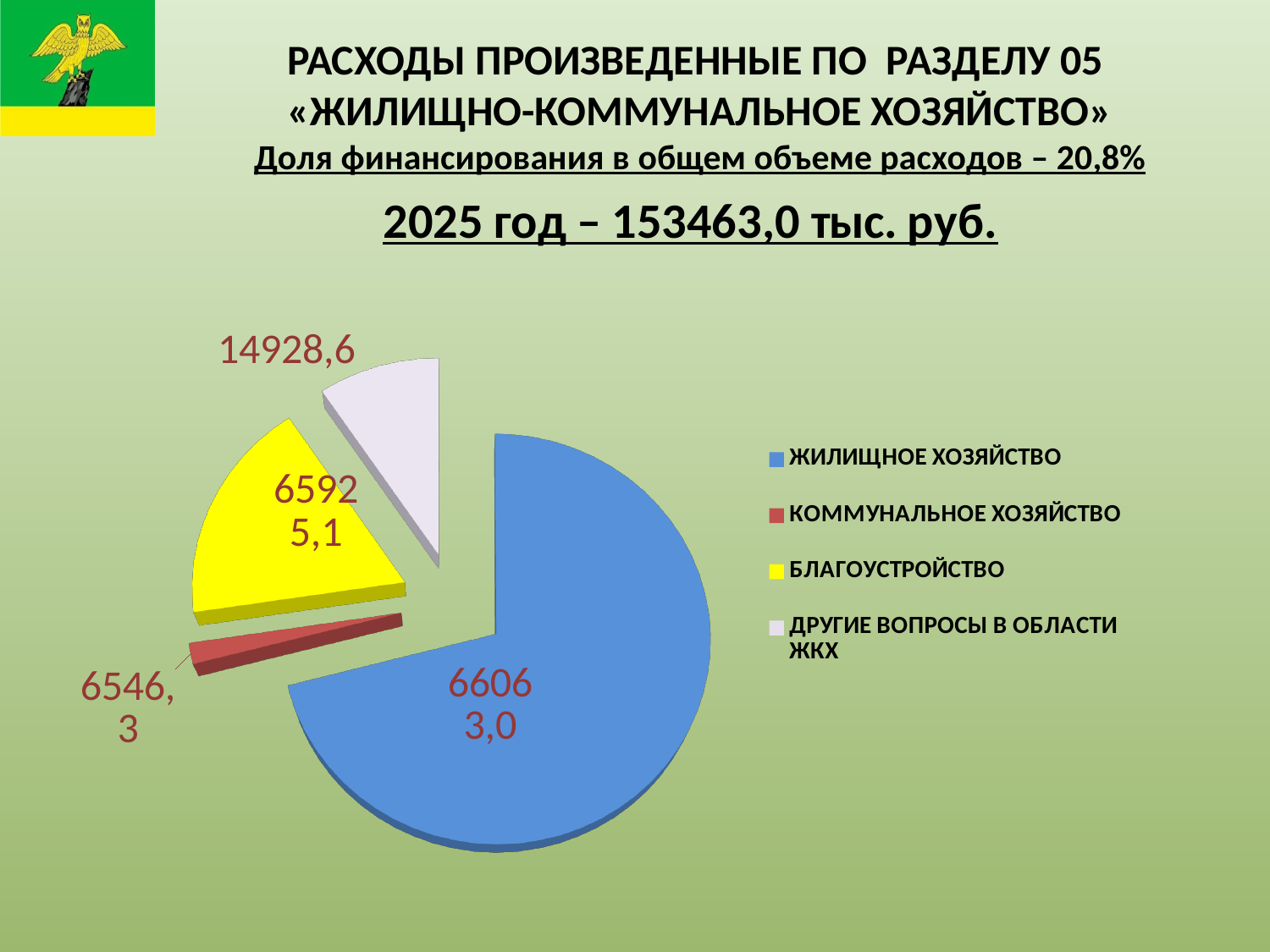
What is the value shown for КОММУНАЛЬНОЕ ХОЗЯЙСТВО? 6546,3 Which category has the smallest slice of the pie? КОММУНАЛЬНОЕ ХОЗЯЙСТВО How many slices does the pie chart have? 4 What total amount for 2025 is stated above the pie chart? 153463,0 тыс. руб. What kind of chart is shown on the slide? pie chart What is the difference between the values for ДРУГИЕ ВОПРОСЫ В ОБЛАСТИ ЖКХ and КОММУНАЛЬНОЕ ХОЗЯЙСТВО? 8382,3 Which is larger, the value for ДРУГИЕ ВОПРОСЫ В ОБЛАСТИ ЖКХ or the value for КОММУНАЛЬНОЕ ХОЗЯЙСТВО? ДРУГИЕ ВОПРОСЫ В ОБЛАСТИ ЖКХ What colour represents БЛАГОУСТРОЙСТВО in the legend? yellow What is the value shown for БЛАГОУСТРОЙСТВО? 65925,1 What is the value shown for ЖИЛИЩНОЕ ХОЗЯЙСТВО? 66063,0 What share of total expenditure does the slide state for this section (Доля финансирования в общем объеме расходов)? 20,8% What is the value shown for ДРУГИЕ ВОПРОСЫ В ОБЛАСТИ ЖКХ? 14928,6